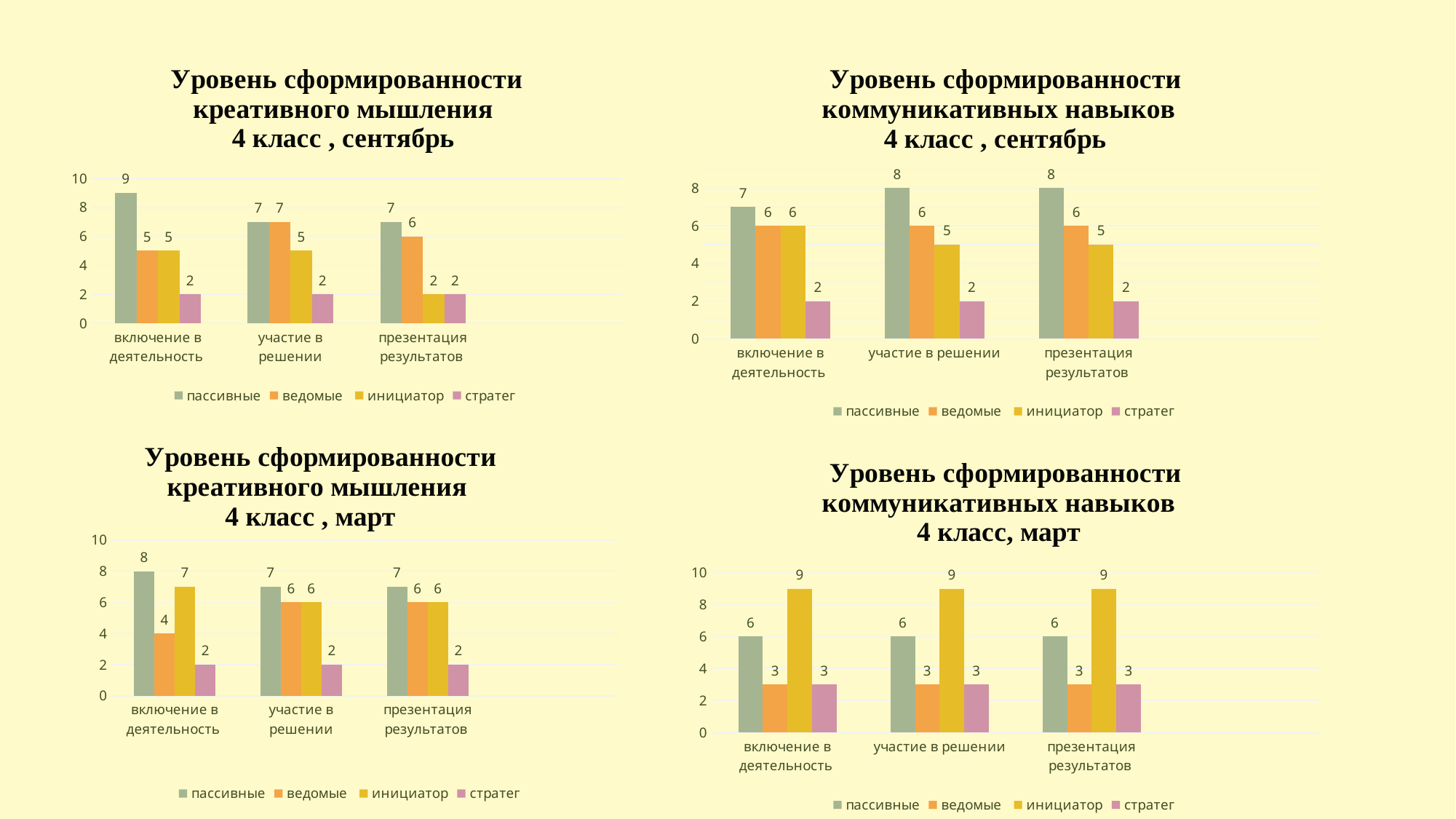
What type of chart is the top-right chart (коммуникативных навыков, сентябрь)? bar chart In the top-right chart (коммуникативных навыков, сентябрь), what is the difference between пассивные and стратег in the category включение в деятельность? 5 In the top-right chart (коммуникативных навыков, сентябрь), what is the value for пассивные in the category участие в решении? 8 In the bottom-right chart (коммуникативных навыков, март), which series has the lowest value in the category презентация результатов? ведомые and стратег (both 3) In the bottom-right chart (коммуникативных навыков, март), which is larger in the category включение в деятельность: пассивные or инициатор? инициатор In the top-left chart (креативного мышления, сентябрь), what is the value for пассивные in the category включение в деятельность? 9 In the top-left chart (креативного мышления, сентябрь), what is the value for инициатор in the category презентация результатов? 2 How many categories are shown on the x axis of the bottom-left chart? 3 In the bottom-left chart (креативного мышления, март), which series has the highest value in the category включение в деятельность? пассивные In the bottom-right chart (коммуникативных навыков, март), what is the value for инициатор in the category участие в решении? 9 How many series does the legend of the top-left chart list? 4 In the bottom-left chart (креативного мышления, март), what is the value for ведомые in the category включение в деятельность? 4